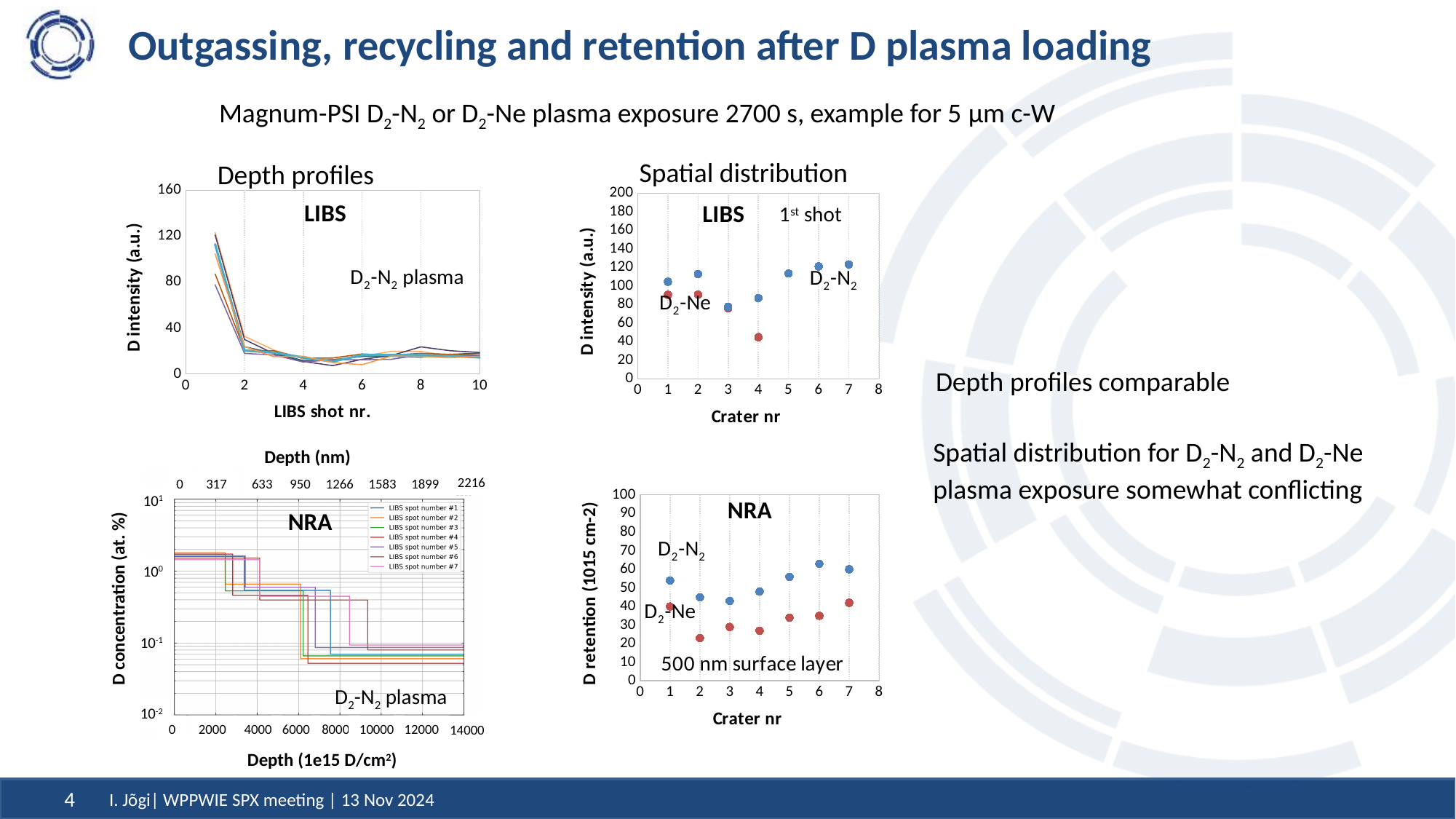
On the top-right 'Spatial distribution' LIBS chart, at crater 4, which is larger: the D2-N2 value or the D2-Ne value? D2-N2 On the top-right 'Spatial distribution' LIBS chart, what kind of chart is it? scatter chart On the top-left 'Depth profiles' LIBS chart, is the D intensity at LIBS shot 4 greater or less than 40? less On the bottom-left NRA depth profile chart, how many LIBS spot numbers does the legend list? 7 On the top-left 'Depth profiles' LIBS chart, what is the label of the x axis? LIBS shot nr. On the bottom-right NRA chart, is the D2-Ne value at crater 2 greater or less than 30? less On the top-right 'Spatial distribution' LIBS chart, is the D2-N2 value at crater 7 greater or less than 100? greater On the top-left 'Depth profiles' LIBS chart, do the D intensity values rise or fall as the LIBS shot number increases from 1 to 10? fall On the top-right 'Spatial distribution' LIBS chart, at which crater number is the D2-Ne value lowest? 4 On the bottom-right NRA chart, at crater 1, which is larger: the D2-N2 value or the D2-Ne value? D2-N2 On the top-right 'Spatial distribution' LIBS chart, how many D2-N2 data points are plotted? 7